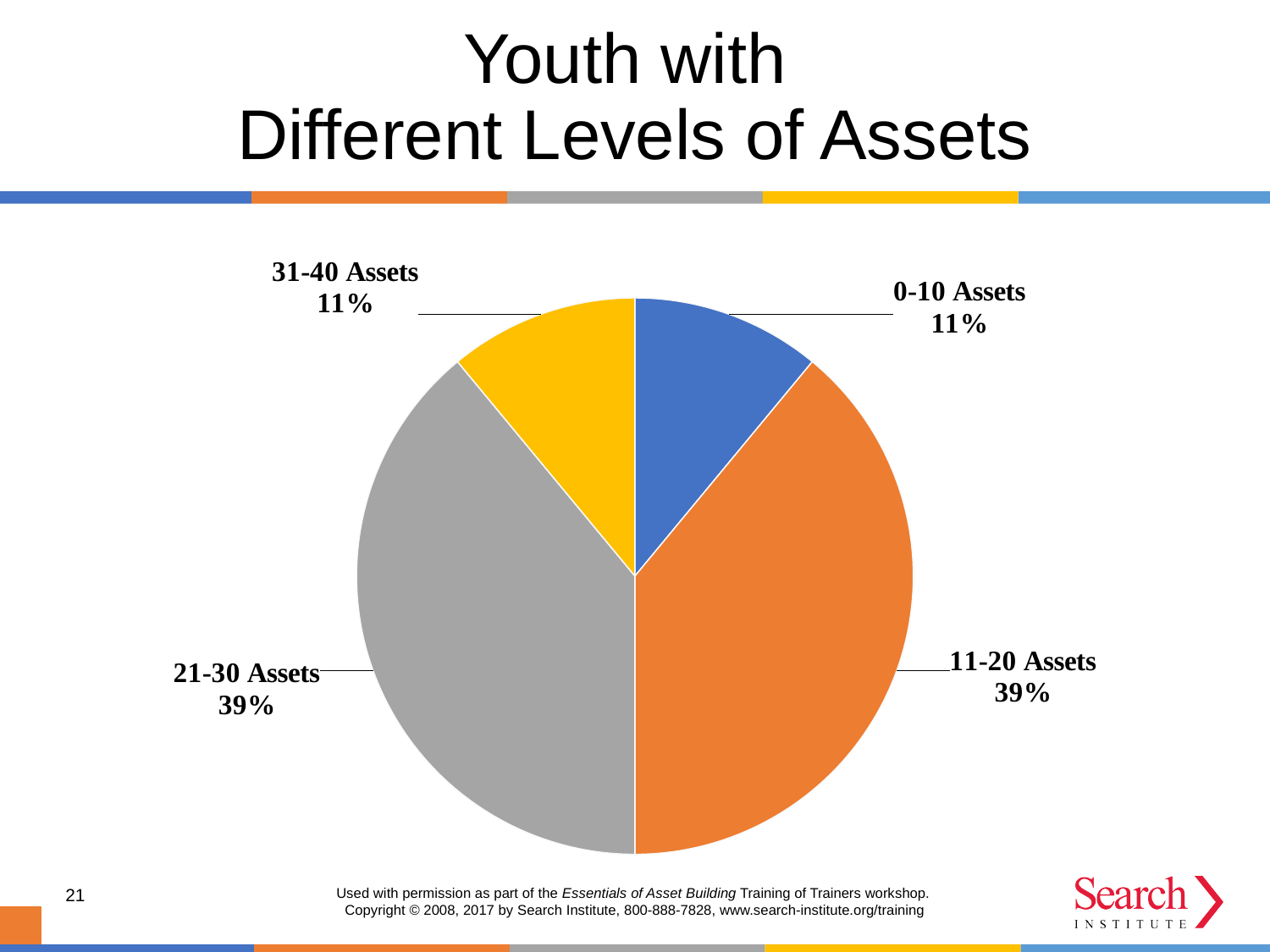
What percentage of youth have 21-30 Assets? 39% What kind of chart is shown on the slide? pie chart What percentage of youth have 31-40 Assets? 11% What is the title of the slide containing the pie chart? Youth with Different Levels of Assets What percentage of youth have 11-20 Assets? 39% How many slices does the pie chart have? 4 What is the difference in percentage points between the 11-20 Assets slice and the 0-10 Assets slice? 28 Which slice is larger, 11-20 Assets or 0-10 Assets? 11-20 Assets Which slice is larger, 21-30 Assets or 31-40 Assets? 21-30 Assets What colour is the 11-20 Assets slice? orange What share of the pie do the 21-30 Assets and 11-20 Assets slices make up together? 78% What percentage of youth have 0-10 Assets? 11%